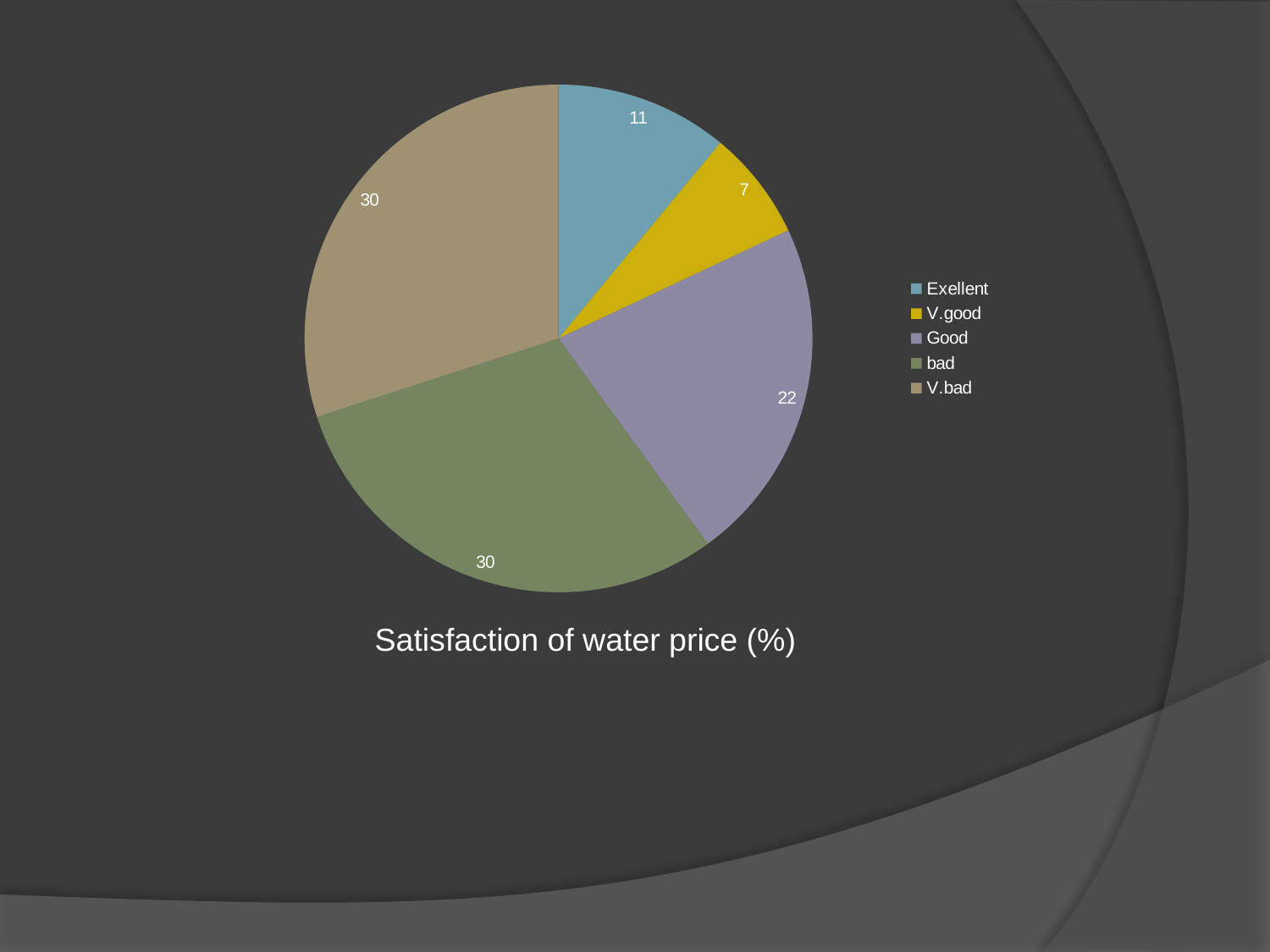
What is the value for Exellent? 11 What share of the pie does the bad slice represent? 30% What is the value for V.bad? 30 What is the value for V.good? 7 What is the difference between the values for Good and V.good? 15 What is the value for Good? 22 How many slices does the pie chart have? 5 Which category has the smallest slice? V.good Which is larger, Good or Exellent? Good What is the value for bad? 30 What type of chart is shown on the slide? pie chart What is the title of the chart? Satisfaction of water price (%)